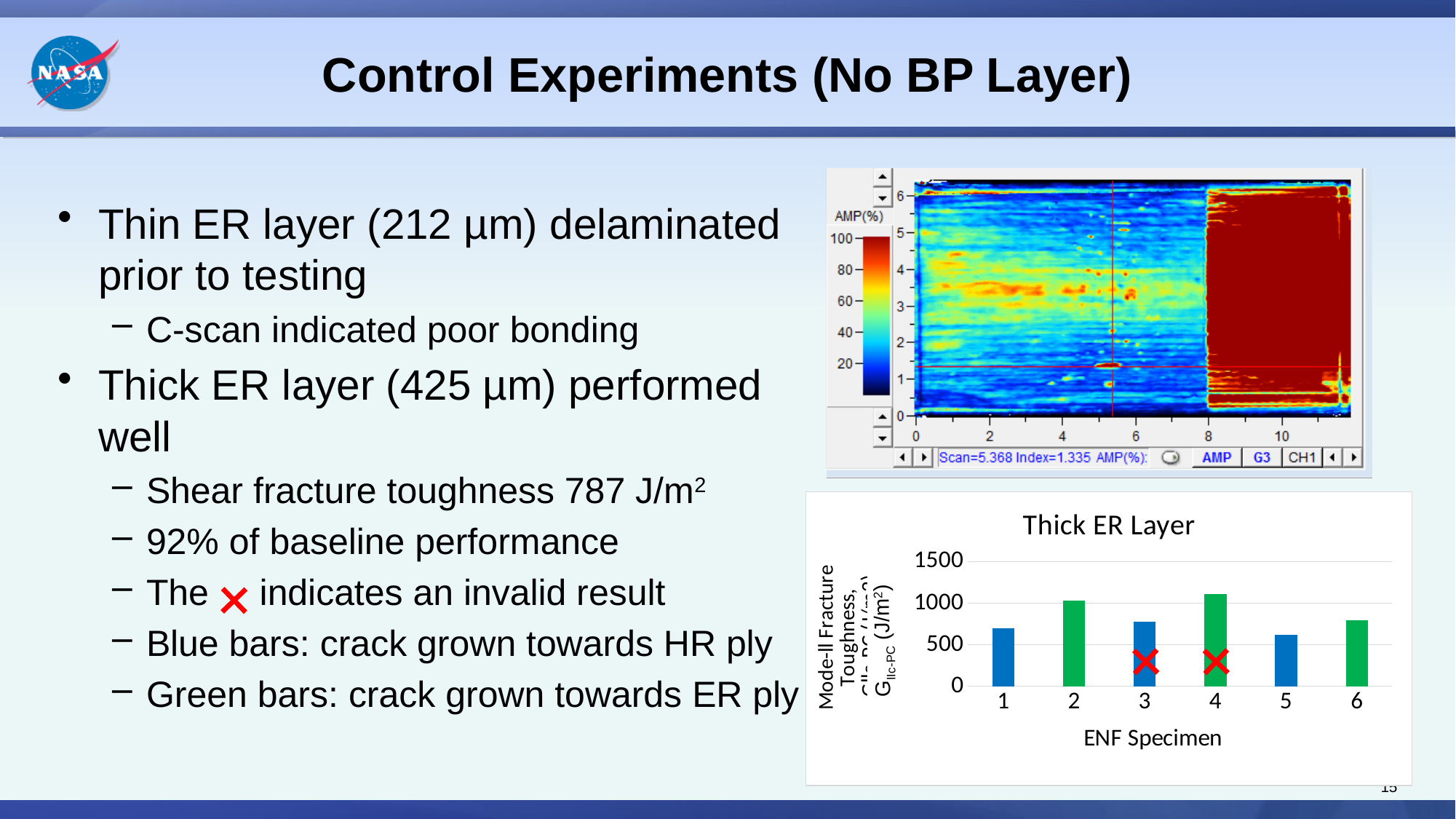
In the 'Thick ER Layer' chart, which ENF specimens are marked with a red X? 3 and 4 In the 'Thick ER Layer' chart, which ENF specimen has the lowest Mode-II fracture toughness? 5 In the 'Thick ER Layer' chart, is the value for ENF specimen 3 greater or less than 1000? less What is the x-axis title of the 'Thick ER Layer' chart? ENF Specimen What kind of chart is the 'Thick ER Layer' chart? bar chart In the 'Thick ER Layer' chart, is the value for ENF specimen 5 greater or less than 1000? less In the 'Thick ER Layer' chart, which ENF specimen has the highest Mode-II fracture toughness? 4 In the 'Thick ER Layer' chart, which has the larger value: ENF specimen 2 or ENF specimen 1? 2 In the 'Thick ER Layer' chart, which has the larger value: ENF specimen 3 or ENF specimen 5? 3 How many ENF specimens are plotted in the 'Thick ER Layer' chart? 6 In the 'Thick ER Layer' chart, is the value for ENF specimen 4 greater or less than 1000? greater